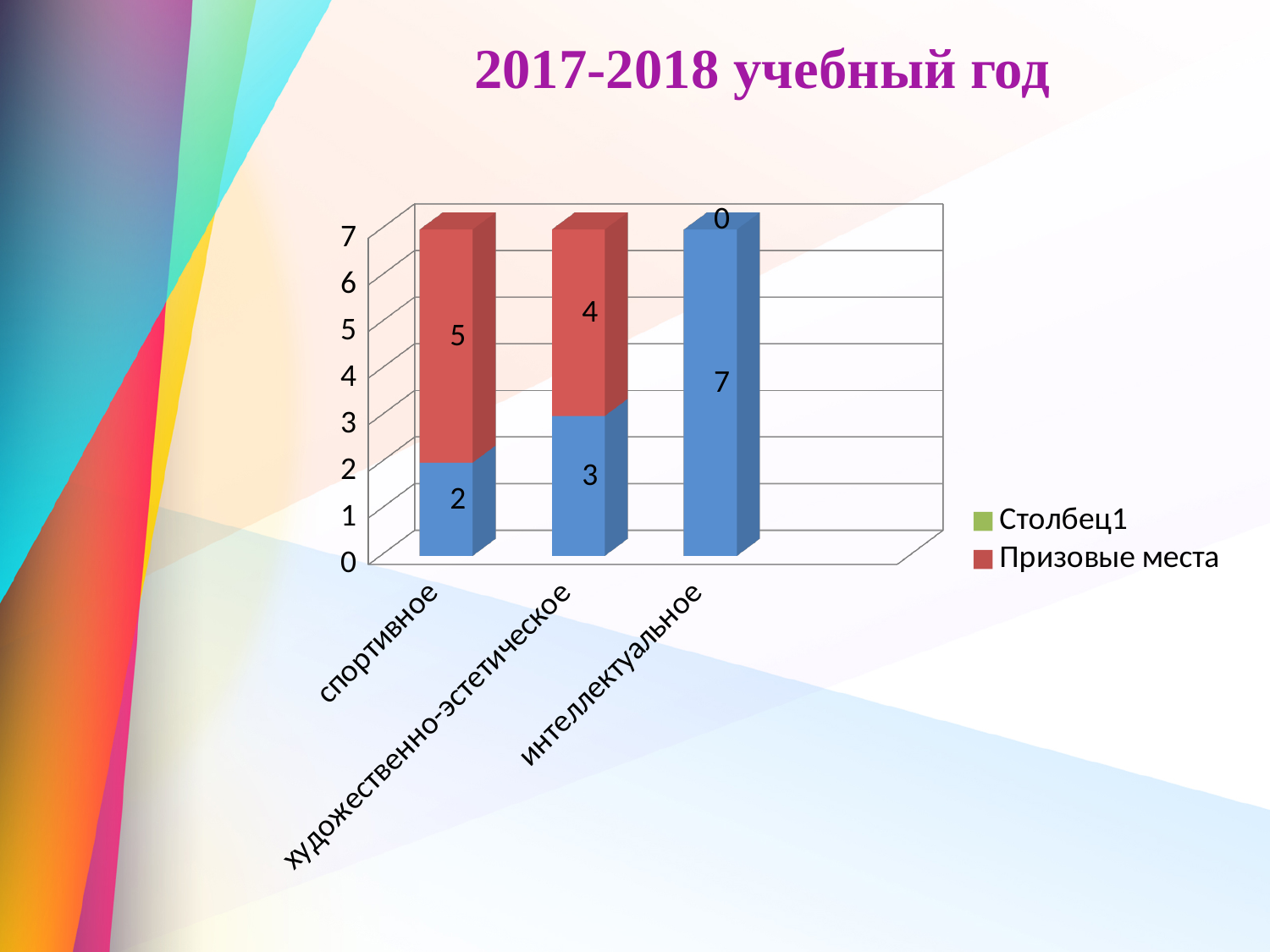
What is the total of the stacked bar for спортивное? 7 Which category has the highest value for Призовые места? спортивное What is the value of the blue segment for интеллектуальное? 7 What is the value of Призовые места for спортивное? 5 How many series does the chart's legend list? 2 What is the value of the blue segment for спортивное? 2 What is the value of Призовые места for интеллектуальное? 0 What kind of chart is shown on the slide? stacked bar chart What is the title of the slide above the chart? 2017-2018 учебный год What is the difference between the Призовые места values for спортивное and художественно-эстетическое? 1 What is the value of Призовые места for художественно-эстетическое? 4 How many categories are shown on the x axis of the chart? 3